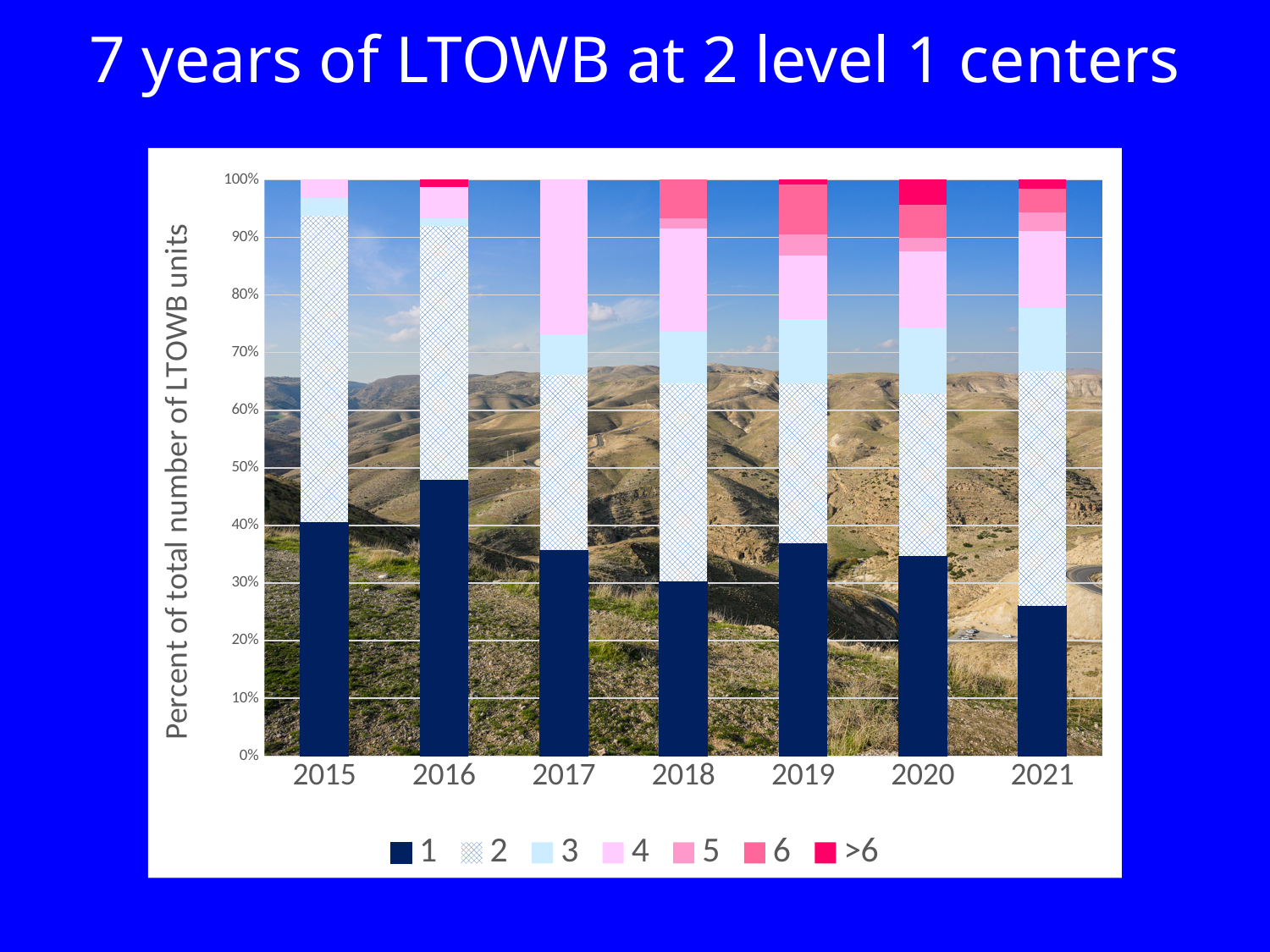
What is the total height of the stacked bar for 2015? 100% Is the value for series 1 in 2021 greater or less than 30%? less In which year is the share of series 1 the highest? 2016 Is the value for series 1 in 2016 greater or less than 40%? greater In which year is the share of series 1 the lowest? 2021 What kind of chart is shown on the slide? Stacked bar chart What is the label on the y axis? Percent of total number of LTOWB units Which year has a larger share of series 1, 2016 or 2021? 2016 How many series does the legend list? 7 How many years (categories) are shown on the x axis? 7 What is the title of the slide's chart? 7 years of LTOWB at 2 level 1 centers Is the value for series 1 in 2017 greater or less than 40%? less